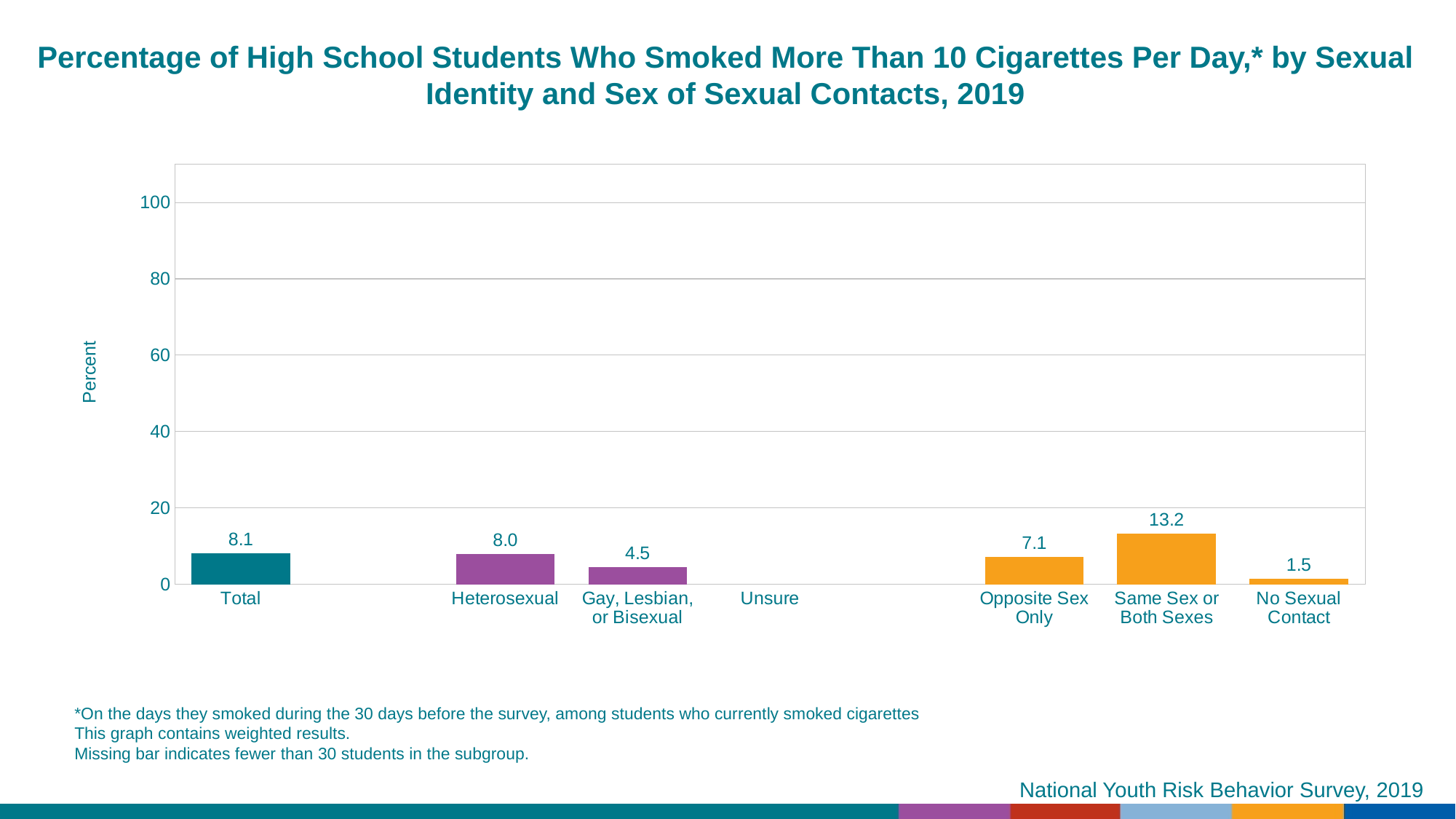
What kind of chart is shown on the slide? bar chart What is the value for Heterosexual? 8.0 Is the value for Same Sex or Both Sexes greater or less than 20? less Which category with a bar has the lowest value? No Sexual Contact What is the difference between the values for Same Sex or Both Sexes and Opposite Sex Only? 6.1 What is the value for No Sexual Contact? 1.5 Which is larger, the value for Heterosexual or the value for Gay, Lesbian, or Bisexual? Heterosexual What is the value for Total? 8.1 What is the value for Gay, Lesbian, or Bisexual? 4.5 What is the value for Same Sex or Both Sexes? 13.2 Which category has the highest value? Same Sex or Both Sexes How many categories are labeled on the x axis? 7